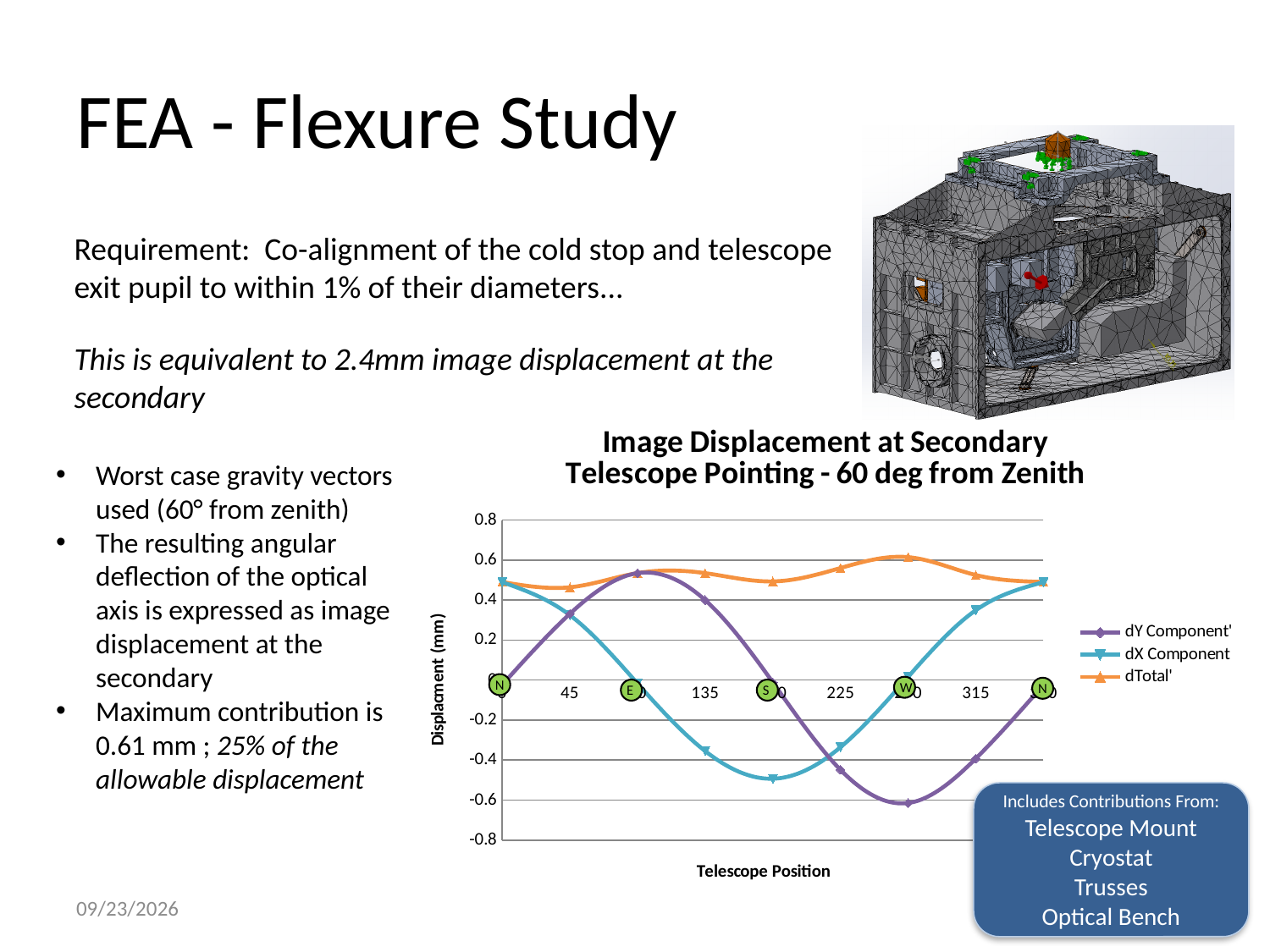
Is the value of the dY Component' series at telescope position 90 greater or less than 0.4? greater Is the value of the dY Component' series at telescope position 270 greater or less than -0.4? less What is the title of the chart's horizontal axis? Telescope Position What kind of chart is shown on the slide? line chart Is the value of the dX Component series at telescope position 180 greater or less than -0.4? less At telescope position 90, which is larger, the dY Component' value or the dX Component value? dY Component' How many series does the chart legend list? 3 Which series has the lowest value at telescope position 270? dY Component' What is the title of the chart's vertical axis? Displacment (mm) Does the dX Component series rise or fall from telescope position 0 to 180? fall Which series has the highest value at telescope position 270? dTotal'